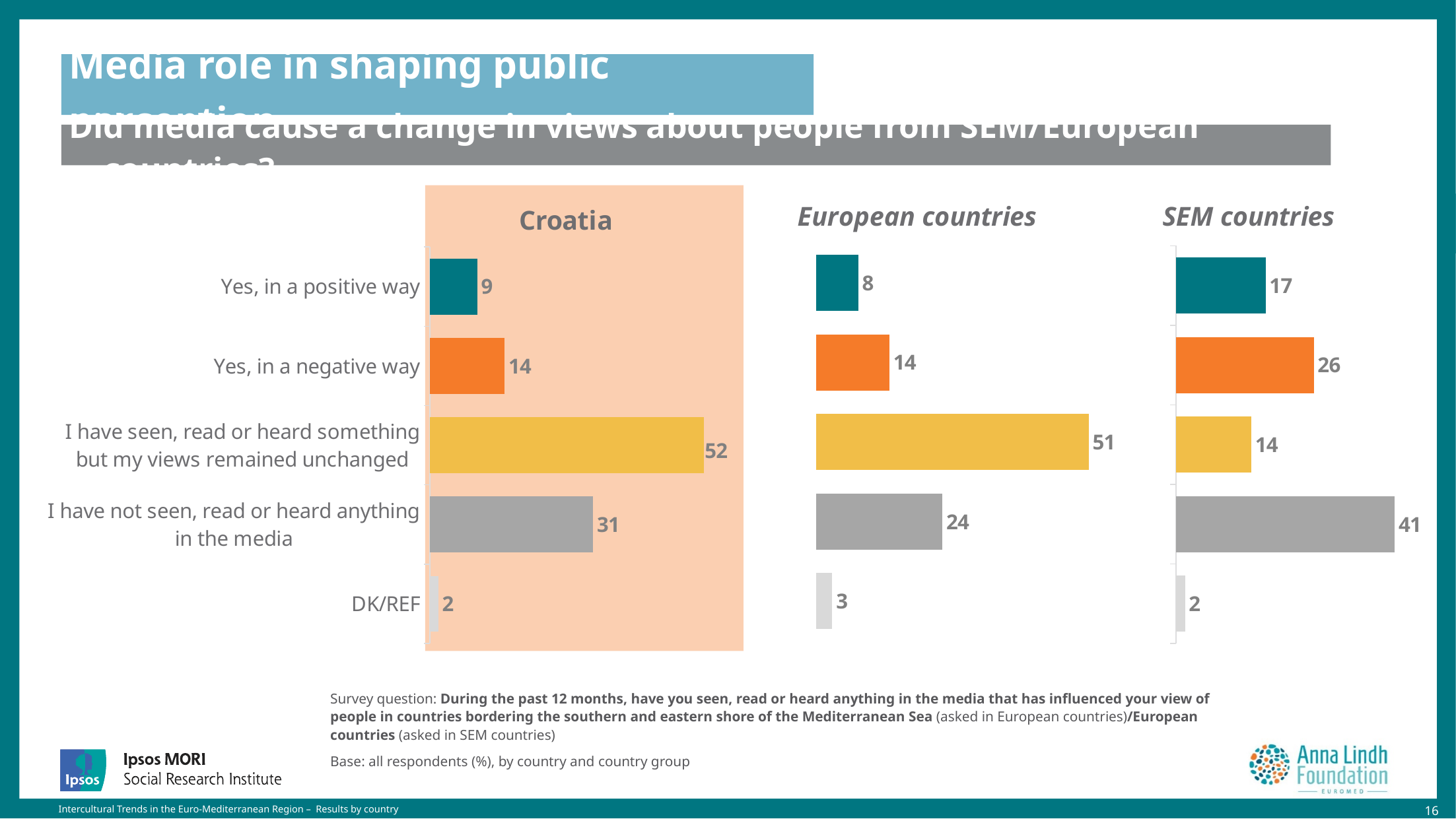
In the SEM countries chart, what is the value for DK/REF? 2 In the SEM countries chart, which category has the highest value? I have not seen, read or heard anything in the media In the European countries chart, which category has the highest value? I have seen, read or heard something but my views remained unchanged In the European countries chart, what is the difference between 'Yes, in a negative way' and 'Yes, in a positive way'? 6 Which is larger: the value for 'Yes, in a positive way' in the SEM countries chart or in the Croatia chart? SEM countries How many categories are shown in the Croatia chart? 5 In the Croatia chart, what is the difference between 'I have seen, read or heard something but my views remained unchanged' and 'I have not seen, read or heard anything in the media'? 21 In the Croatia chart, what is the value for 'Yes, in a positive way'? 9 In the SEM countries chart, what is the value for 'Yes, in a negative way'? 26 In the Croatia chart, which category has the lowest value? DK/REF What kind of chart is the Croatia chart? Bar chart In the European countries chart, what is the value for 'I have seen, read or heard something but my views remained unchanged'? 51